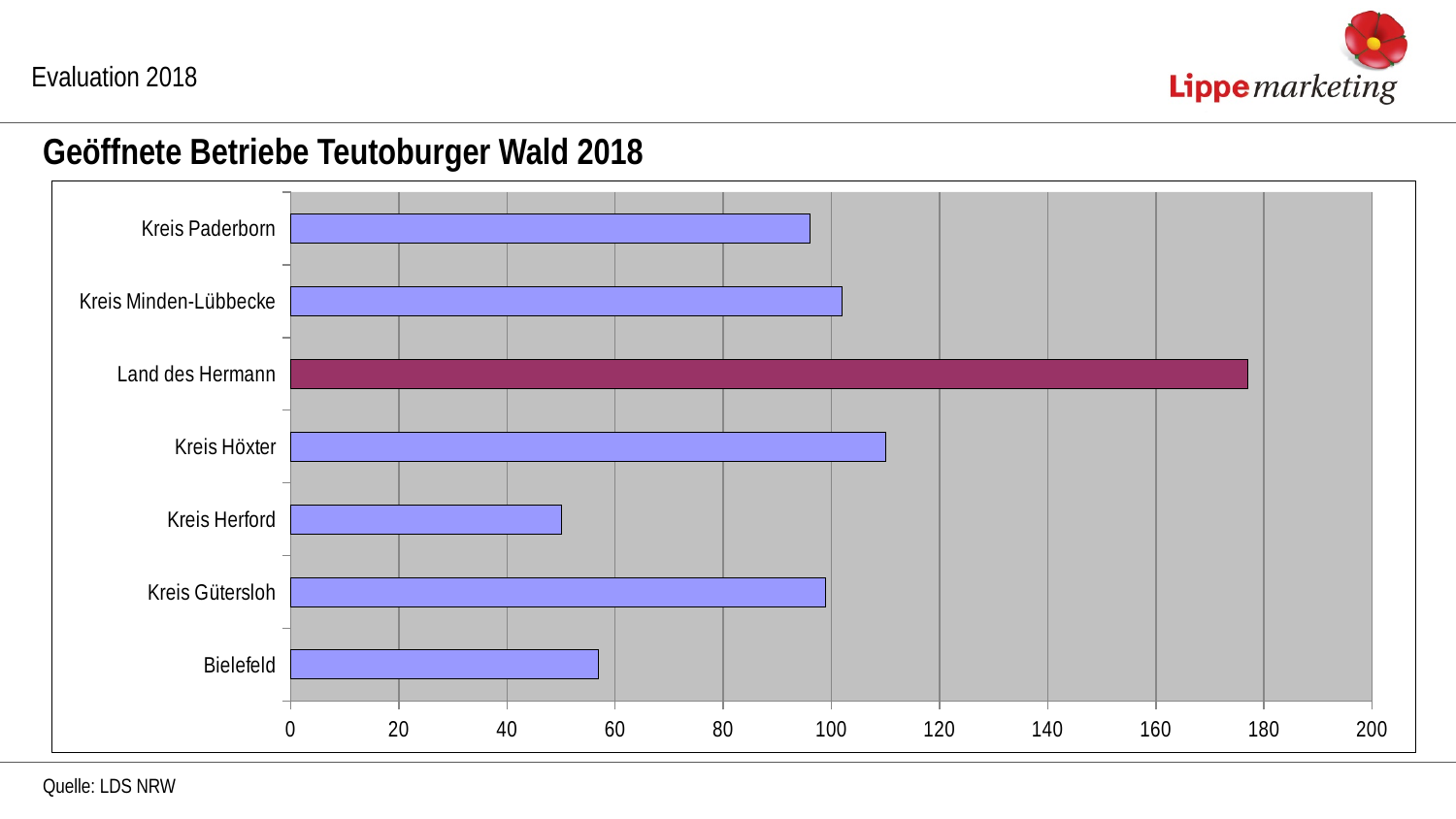
Is the value for Land des Hermann greater or less than 160? greater Which category's bar is shown in a different colour from the others? Land des Hermann Which category has the lowest value? Kreis Herford How many categories are shown in the chart? 7 What is the title of the chart? Geöffnete Betriebe Teutoburger Wald 2018 Is the value for Bielefeld greater or less than 80? less Which has the larger value, Kreis Höxter or Kreis Paderborn? Kreis Höxter What kind of chart is shown on the slide? bar chart Which category has the highest value? Land des Hermann Is the value for Kreis Herford greater or less than 60? less Which has the larger value, Bielefeld or Kreis Gütersloh? Kreis Gütersloh